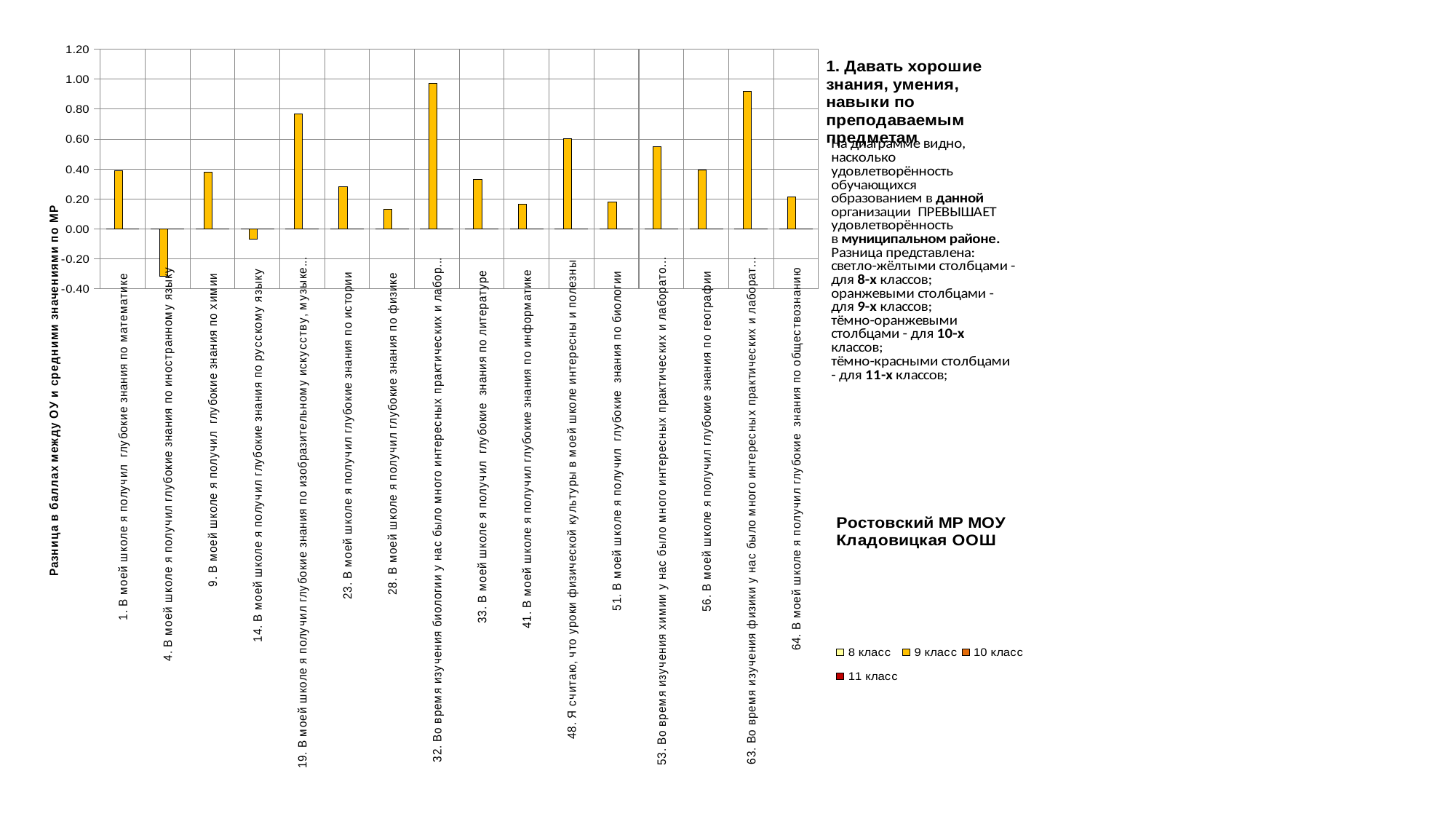
How many categories in the chart have a negative value? 2 Which is larger: the value for '48. Я считаю, что уроки физической культуры в моей школе интересны и полезны' or for '23. В моей школе я получил глубокие знания по истории'? 48. Я считаю, что уроки физической культуры в моей школе интересны и полезны Is the value for '19. В моей школе я получил глубокие знания по изобразительному искусству, музыке...' greater or less than 0.60? greater Which category has the lowest value in the chart? 4. В моей школе я получил глубокие знания по иностранному языку What is the title of the vertical axis of the chart? Разница в баллах между ОУ и средними значениями по МР Is the value for '28. В моей школе я получил глубокие знания по физике' greater or less than 0.20? less How many series does the chart legend list? 4 Is the value for '32. Во время изучения биологии у нас было много интересных практических и лабор...' greater or less than 0.80? greater How many categories are plotted along the x axis of the chart? 16 What kind of chart is shown on the slide? bar chart Which is larger: the value for '1. В моей школе я получил глубокие знания по математике' or for '41. В моей школе я получил глубокие знания по информатике'? 1. В моей школе я получил глубокие знания по математике